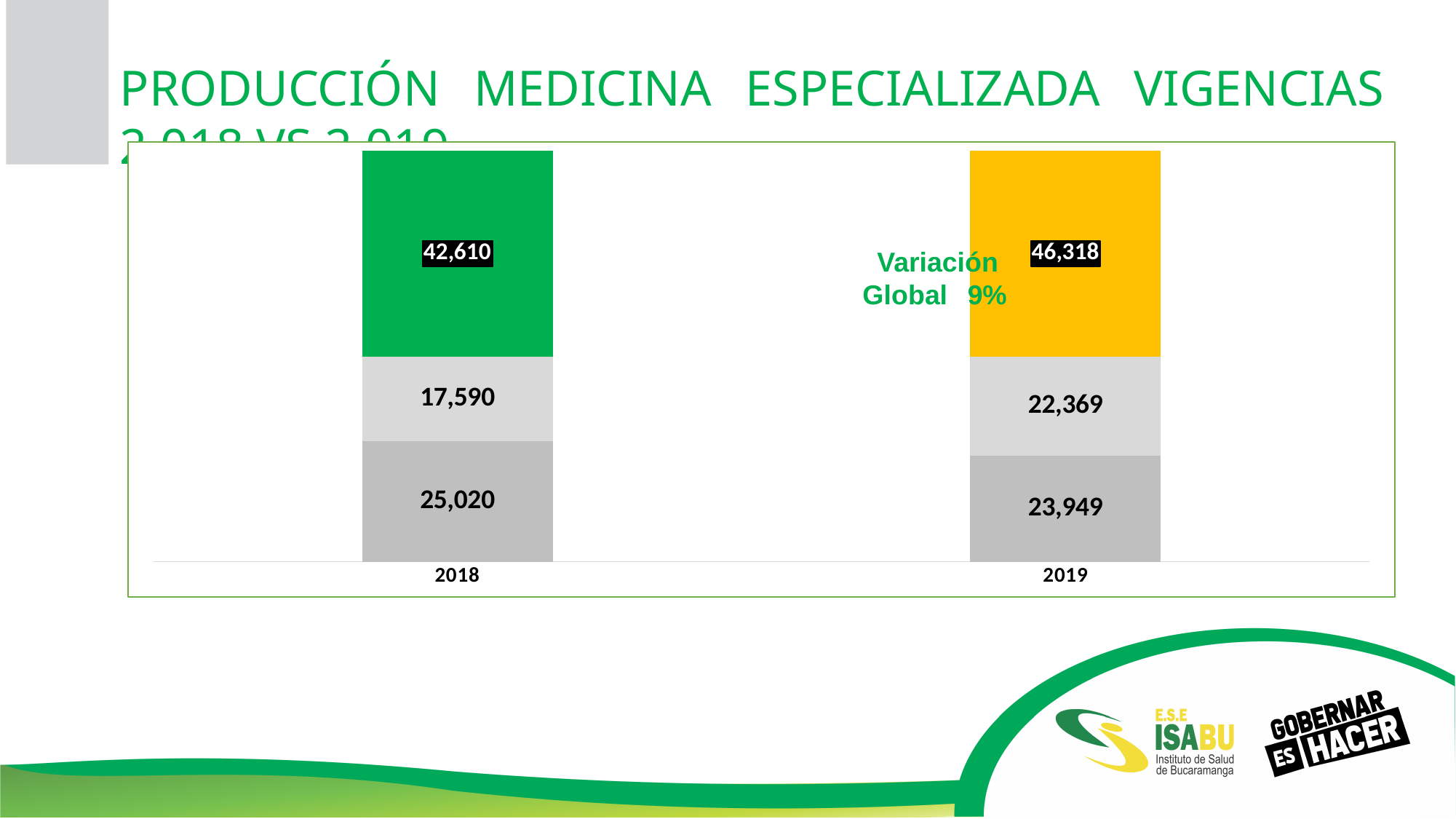
What is the value of the top (yellow) segment of the 2019 bar? 46,318 What is the value of the top (green) segment of the 2018 bar? 42,610 How many bars (categories) are plotted in the chart? 2 Which year has the larger middle (light gray) segment, 2018 or 2019? 2019 What is the difference between the top segment values of 2019 (46,318) and 2018 (42,610)? 3,708 What global variation percentage is annotated on the chart? 9% What is the total of the stacked bar for 2018? 85,220 What is the total of the stacked bar for 2019? 92,636 Which year has the larger bottom (dark gray) segment, 2018 or 2019? 2018 What is the value of the bottom (dark gray) segment of the 2019 bar? 23,949 What type of chart is shown on the slide? stacked bar chart What is the value of the middle (light gray) segment of the 2018 bar? 17,590